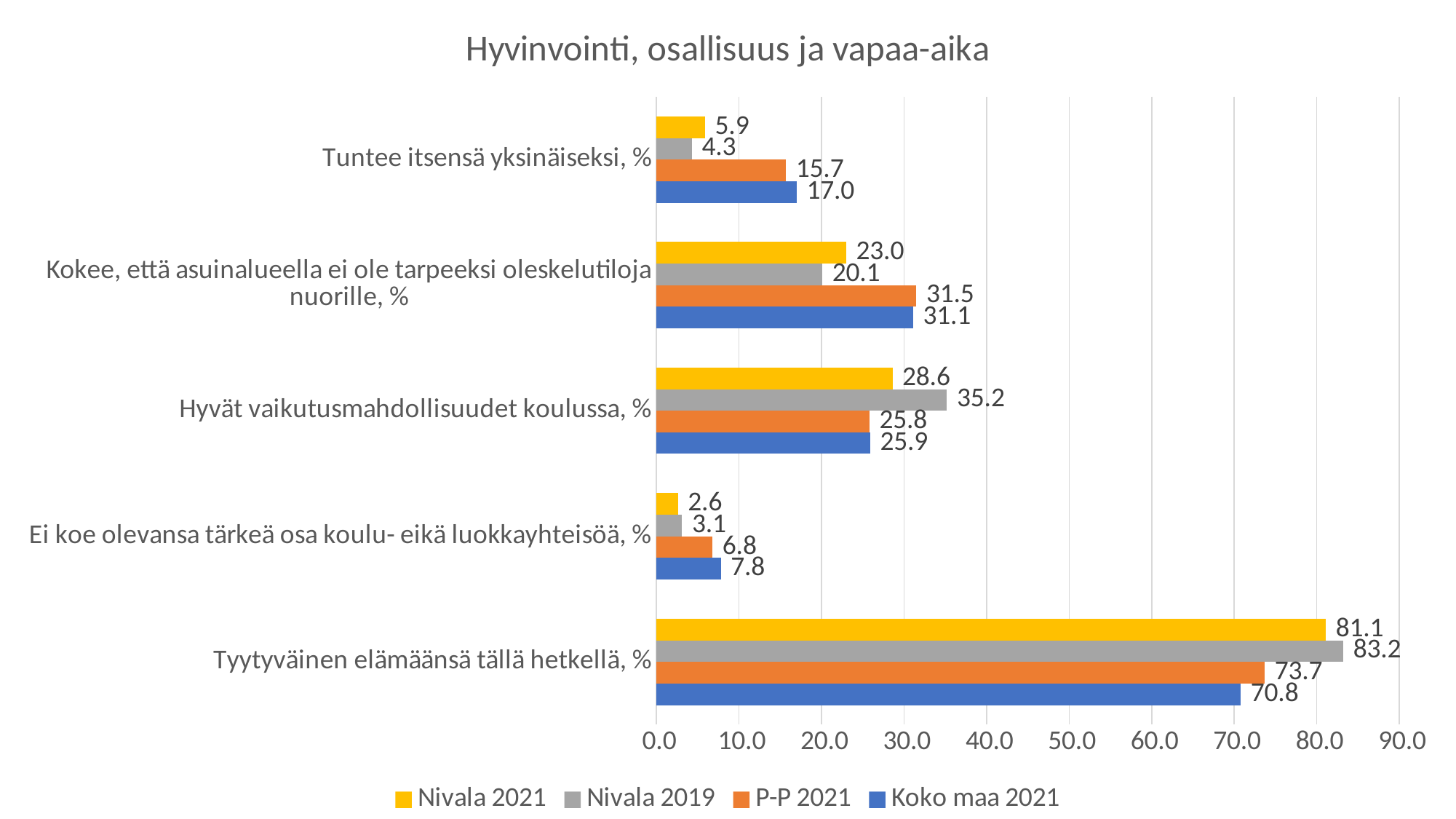
What is the difference between the Koko maa 2021 and Nivala 2021 values for "Tuntee itsensä yksinäiseksi, %"? 11.1 How many categories are shown on the chart? 5 What kind of chart is shown on the slide? bar chart What is the value for Nivala 2021 in the category "Tuntee itsensä yksinäiseksi, %"? 5.9 How many series does the legend list? 4 Which series has the highest value in the category "Tyytyväinen elämäänsä tällä hetkellä, %"? Nivala 2019 Which series has the lowest value in the category "Ei koe olevansa tärkeä osa koulu- eikä luokkayhteisöä, %"? Nivala 2021 Which is larger for "Kokee, että asuinalueella ei ole tarpeeksi oleskelutiloja nuorille, %": Nivala 2021 or P-P 2021? P-P 2021 What is the value for Nivala 2019 in the category "Hyvät vaikutusmahdollisuudet koulussa, %"? 35.2 What is the title of the chart? Hyvinvointi, osallisuus ja vapaa-aika What is the value for Koko maa 2021 in the category "Tyytyväinen elämäänsä tällä hetkellä, %"? 70.8 Is the Nivala 2019 value for "Tyytyväinen elämäänsä tällä hetkellä, %" greater or less than 80.0? greater